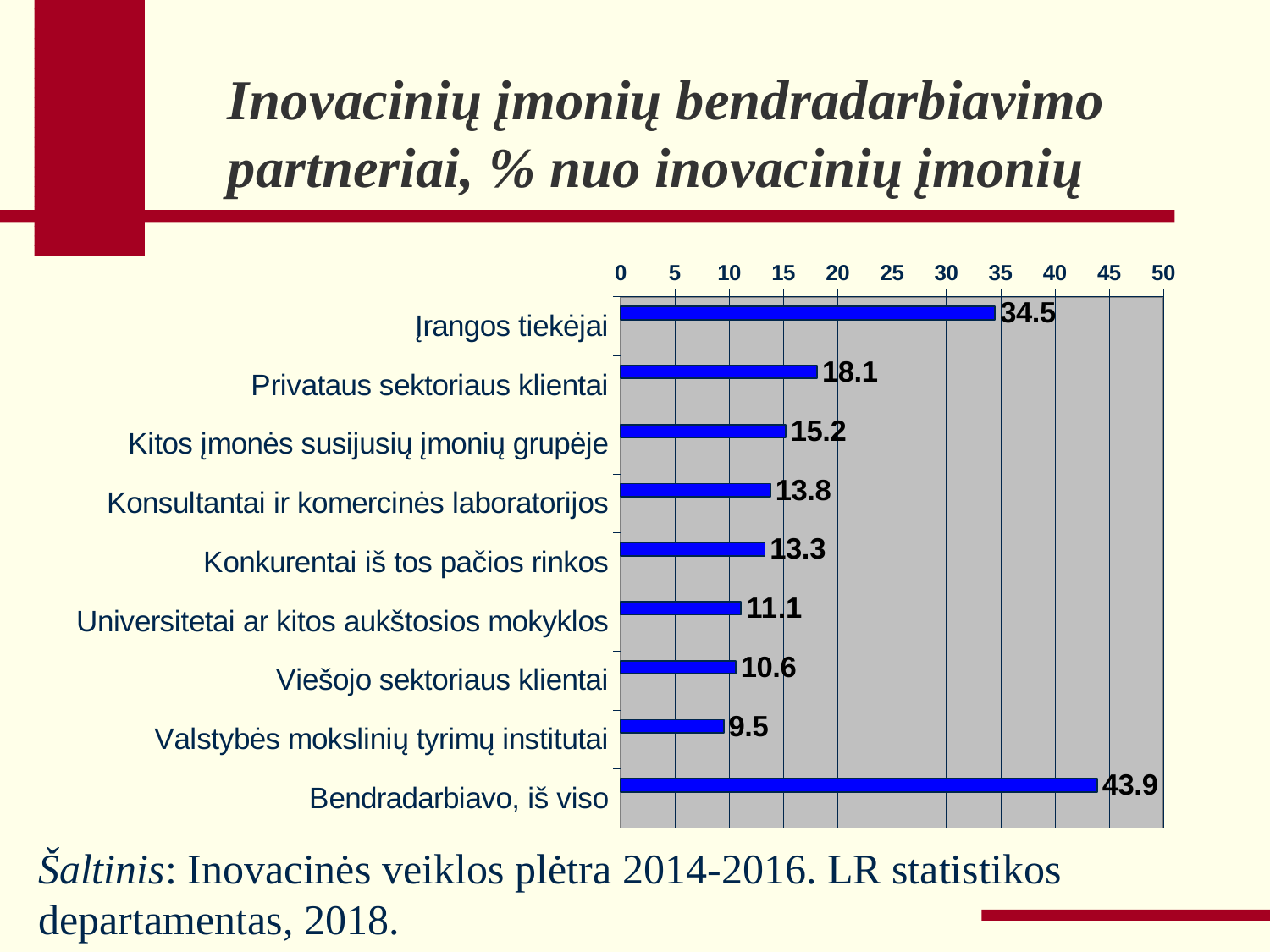
What value is shown for Įrangos tiekėjai? 34.5 Which category has the highest value? Bendradarbiavo, iš viso What kind of chart is shown on the slide? bar chart What is the difference between the values for Konkurentai iš tos pačios rinkos and Valstybės mokslinių tyrimų institutai? 3.8 How many categories are shown in the chart? 9 Which is larger: the value for Kitos įmonės susijusių įmonių grupėje or the value for Konsultantai ir komercinės laboratorijos? Kitos įmonės susijusių įmonių grupėje What is the difference between the values for Įrangos tiekėjai and Privataus sektoriaus klientai? 16.4 What value is shown for Bendradarbiavo, iš viso? 43.9 Is the value for Viešojo sektoriaus klientai greater or less than 15? less Which category has the lowest value? Valstybės mokslinių tyrimų institutai What is the maximum value shown on the chart's value axis? 50 What value is shown for Universitetai ar kitos aukštosios mokyklos? 11.1